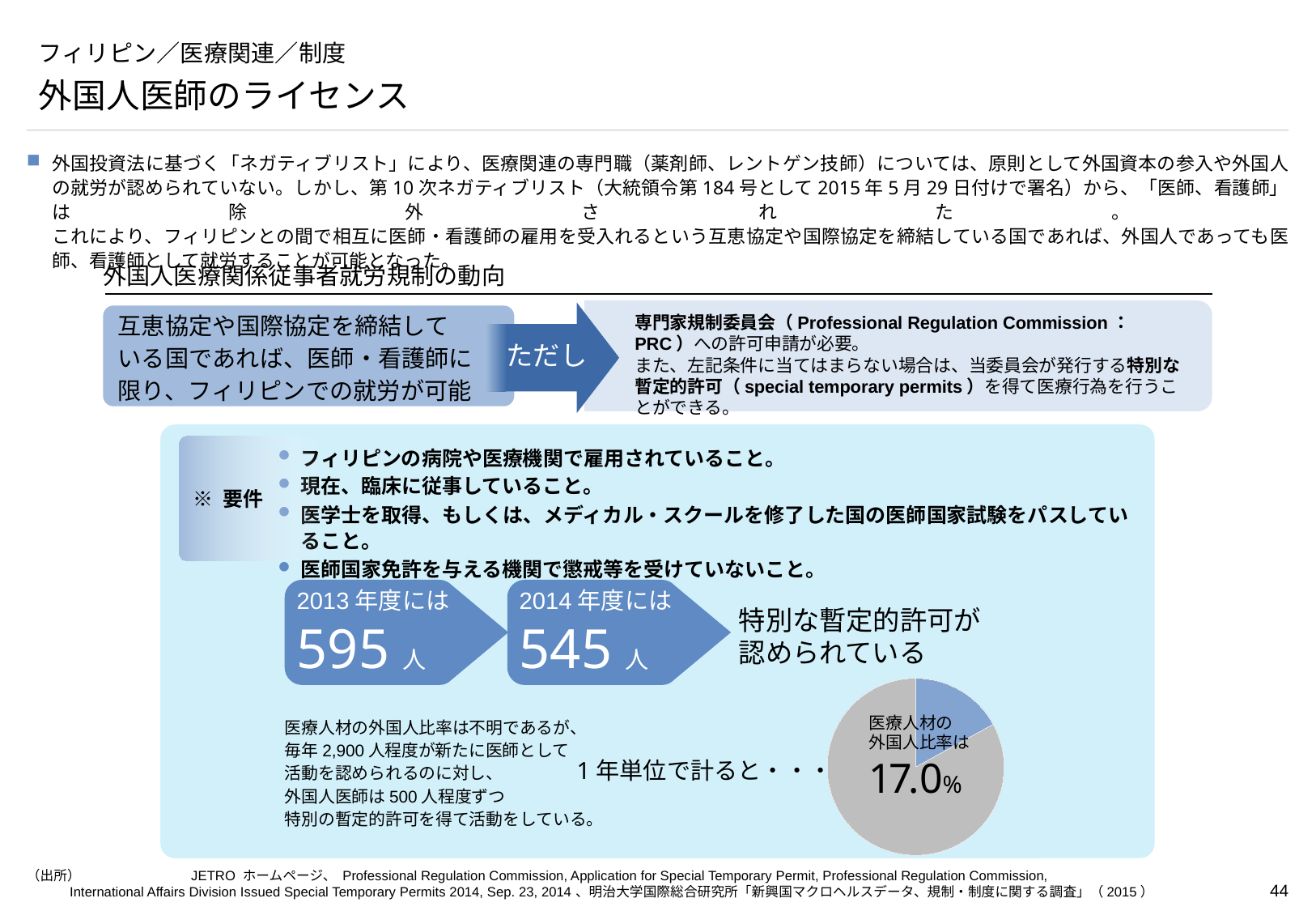
How many slices does the pie chart have? 2 Is the blue slice in the pie chart greater or less than 50% of the pie? less In the pie chart, which slice is larger: the blue slice or the gray slice? the gray slice What share of the pie does the blue slice represent? 17.0% What colour is the slice in the pie chart that represents the 17.0% foreign ratio? blue What kind of chart is shown at the bottom right of the slide? pie chart In the pie chart, what value is shown for 医療人材の外国人比率 (the foreign ratio of medical personnel)? 17.0%